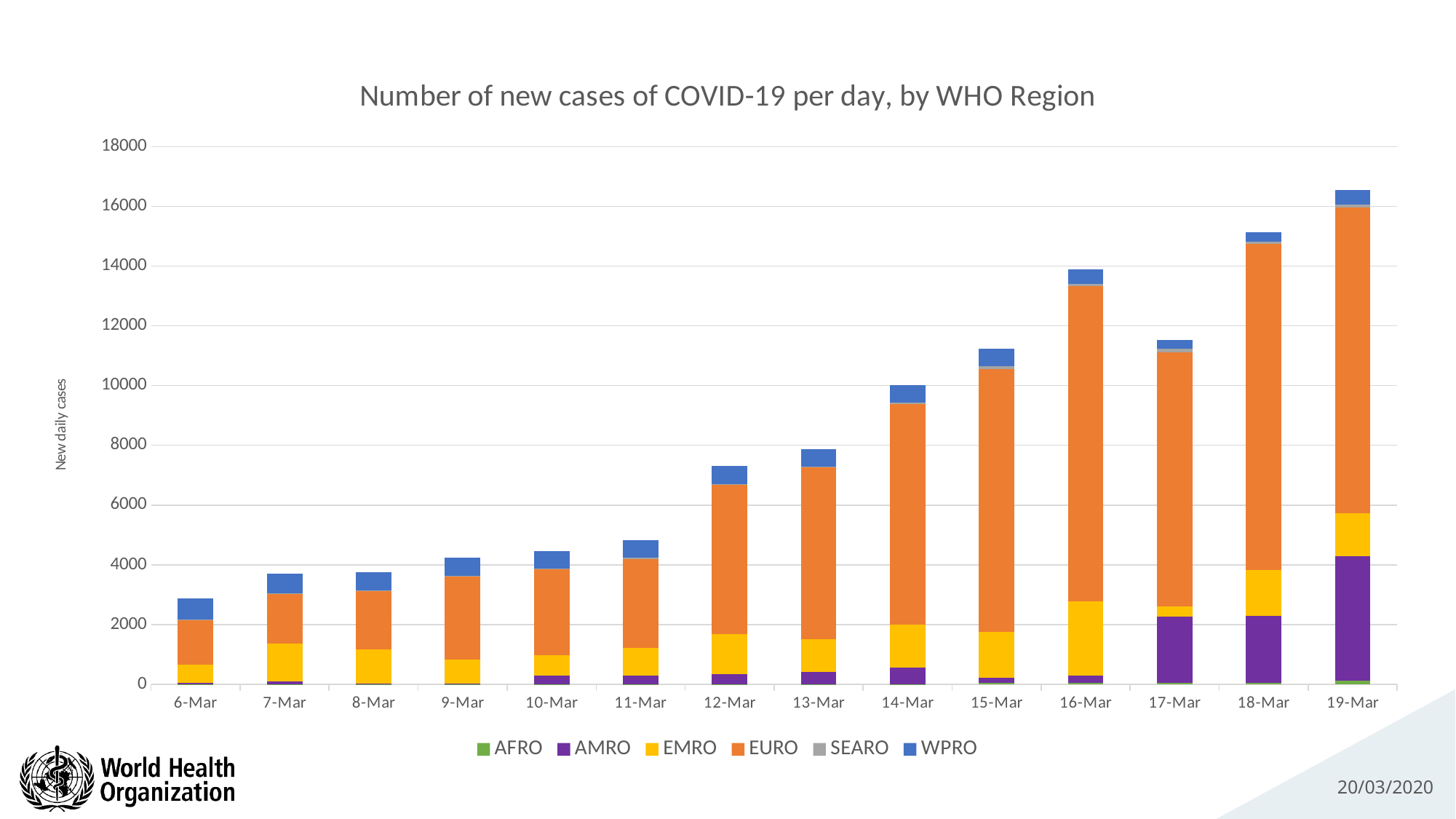
Which date has the lowest total number of new daily cases? 6-Mar What is the title of the chart? Number of new cases of COVID-19 per day, by WHO Region What kind of chart is shown on the slide? Stacked bar chart Which date has the highest total number of new daily cases? 19-Mar Which WHO region contributes the largest share of new cases on 19-Mar? EURO Do the total new daily cases generally rise or fall from 6-Mar to 19-Mar? Rise Which date has a larger total of new cases, 16-Mar or 17-Mar? 16-Mar Is the total number of new cases on 6-Mar greater or less than 4000? less How many dates are shown along the x axis of the chart? 14 Is the total number of new cases on 19-Mar greater or less than 16000? greater How many WHO regions does the legend list? 6 Is the total number of new cases on 17-Mar greater or less than 12000? less